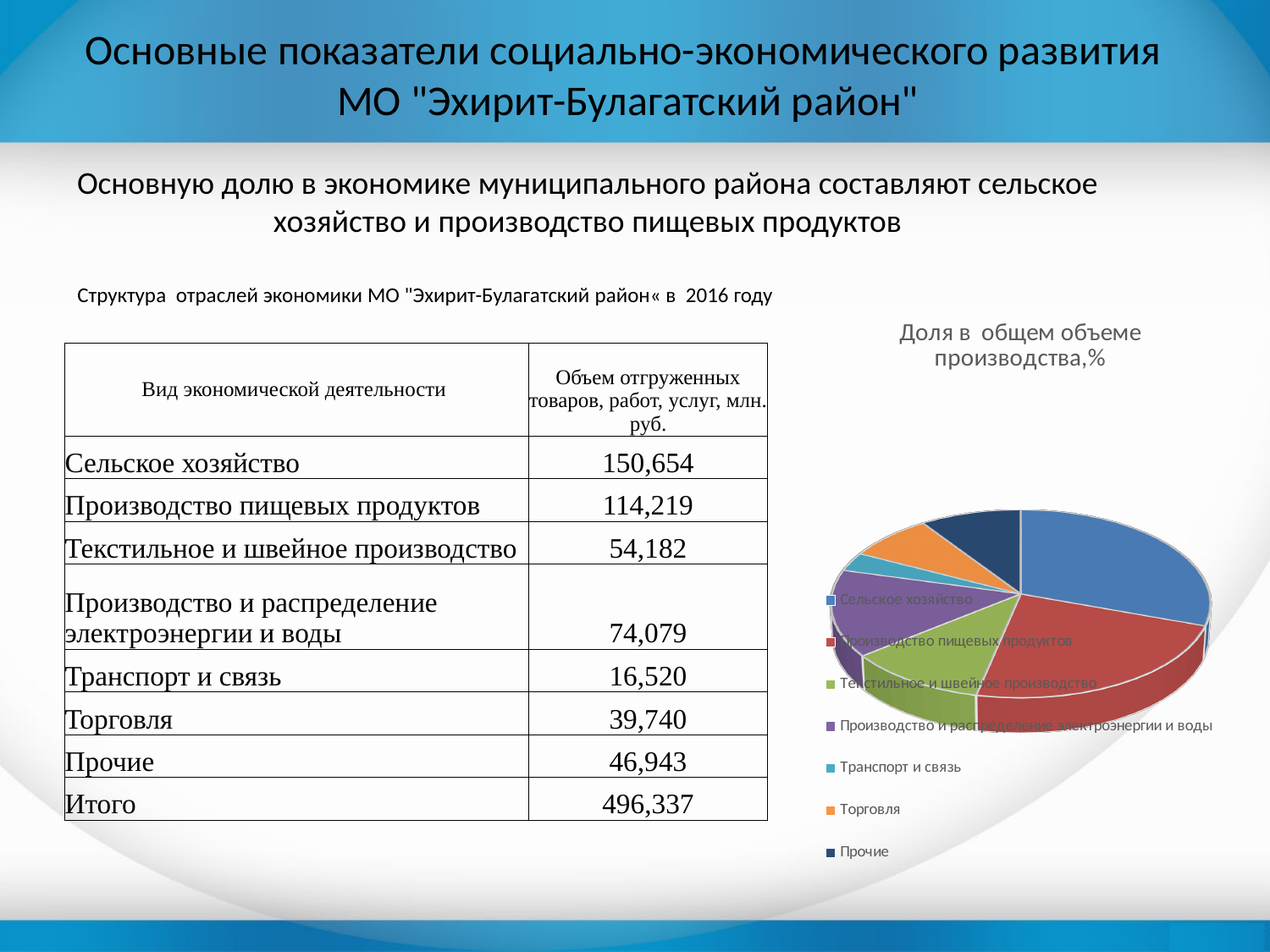
In the pie chart, which slice is larger: Сельское хозяйство or Торговля? Сельское хозяйство How many slices does the pie chart have? 7 Which category has the smallest slice in the pie chart? Транспорт и связь Which colour represents Сельское хозяйство in the pie chart? blue What is the title of the pie chart? Доля в общем объеме производства,% How many entries does the legend of the pie chart list? 7 What kind of chart is shown on the slide? pie chart Which category has the largest slice in the pie chart? Сельское хозяйство In the pie chart, which slice is larger: Производство и распределение электроэнергии и воды or Транспорт и связь? Производство и распределение электроэнергии и воды In the pie chart, which slice is larger: Производство пищевых продуктов or Текстильное и швейное производство? Производство пищевых продуктов